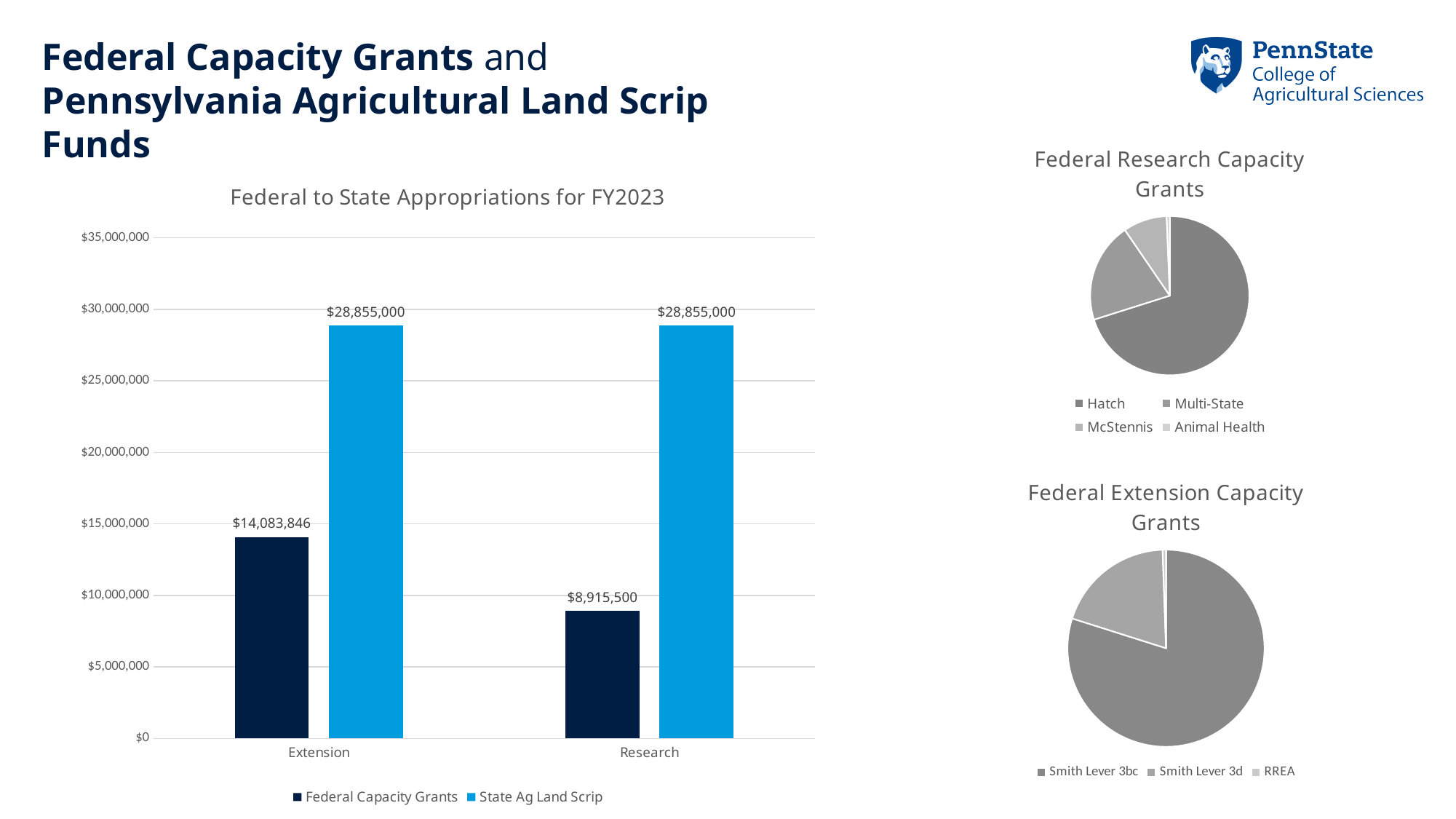
In the 'Federal to State Appropriations for FY2023' chart, what is the difference between the Federal Capacity Grants values for Extension and Research? $5,168,346 What kind of chart is 'Federal to State Appropriations for FY2023'? bar chart How many categories does the legend of the 'Federal Extension Capacity Grants' pie chart list? 3 In the 'Federal to State Appropriations for FY2023' chart, which is larger for Extension: Federal Capacity Grants or State Ag Land Scrip? State Ag Land Scrip In the 'Federal Research Capacity Grants' pie chart, which category has the largest slice? Hatch In the 'Federal to State Appropriations for FY2023' chart, what is the Federal Capacity Grants value for Extension? $14,083,846 In the 'Federal to State Appropriations for FY2023' chart, what is the State Ag Land Scrip value for Research? $28,855,000 How many series does the legend of the 'Federal to State Appropriations for FY2023' chart list? 2 In the 'Federal to State Appropriations for FY2023' chart, which category has the lower Federal Capacity Grants value? Research In the 'Federal Extension Capacity Grants' pie chart, which category has the largest slice? Smith Lever 3bc In the 'Federal to State Appropriations for FY2023' chart, what is the Federal Capacity Grants value for Research? $8,915,500 In the 'Federal to State Appropriations for FY2023' chart, is the Federal Capacity Grants value for Research greater or less than $10,000,000? less